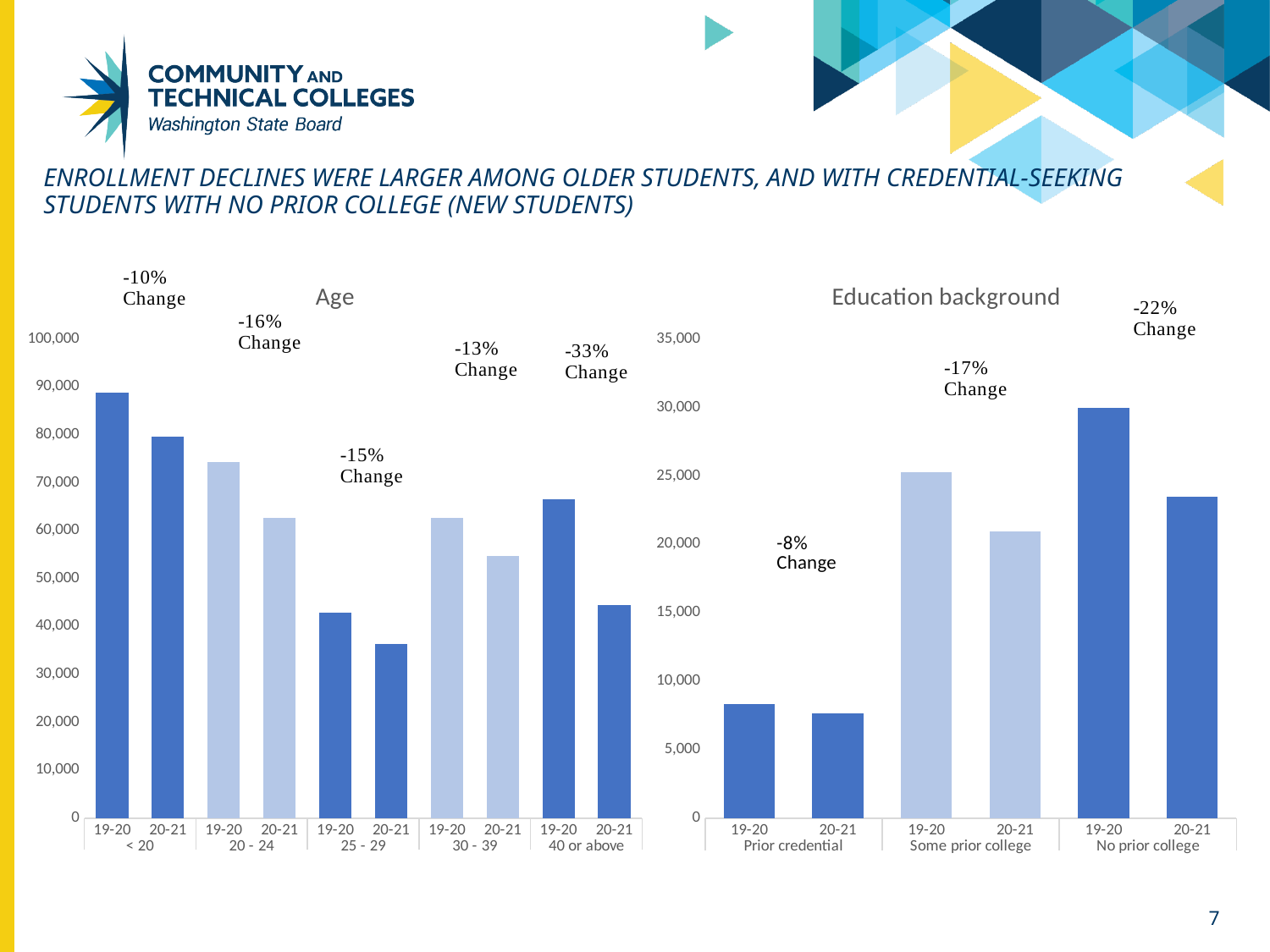
On the Age chart, is the 19-20 value for < 20 greater or less than 80,000? greater On the Age chart, what percent change is annotated for the 40 or above age group? -33% Change What kind of chart is the Age chart? bar chart On the Age chart, which age group has the shortest 20-21 bar? 25 - 29 On the Education background chart, what percent change is annotated for No prior college? -22% Change How many education background categories are shown on the Education background chart? 3 On the Age chart, what percent change is annotated for the < 20 age group? -10% Change On the Education background chart, which category has the tallest 19-20 bar? No prior college On the Age chart, which age group has the tallest 19-20 bar? < 20 On the Education background chart, what percent change is annotated for Prior credential? -8% Change How many age groups are shown on the Age chart? 5 On the Education background chart, is the 19-20 value for Prior credential greater or less than 10,000? less